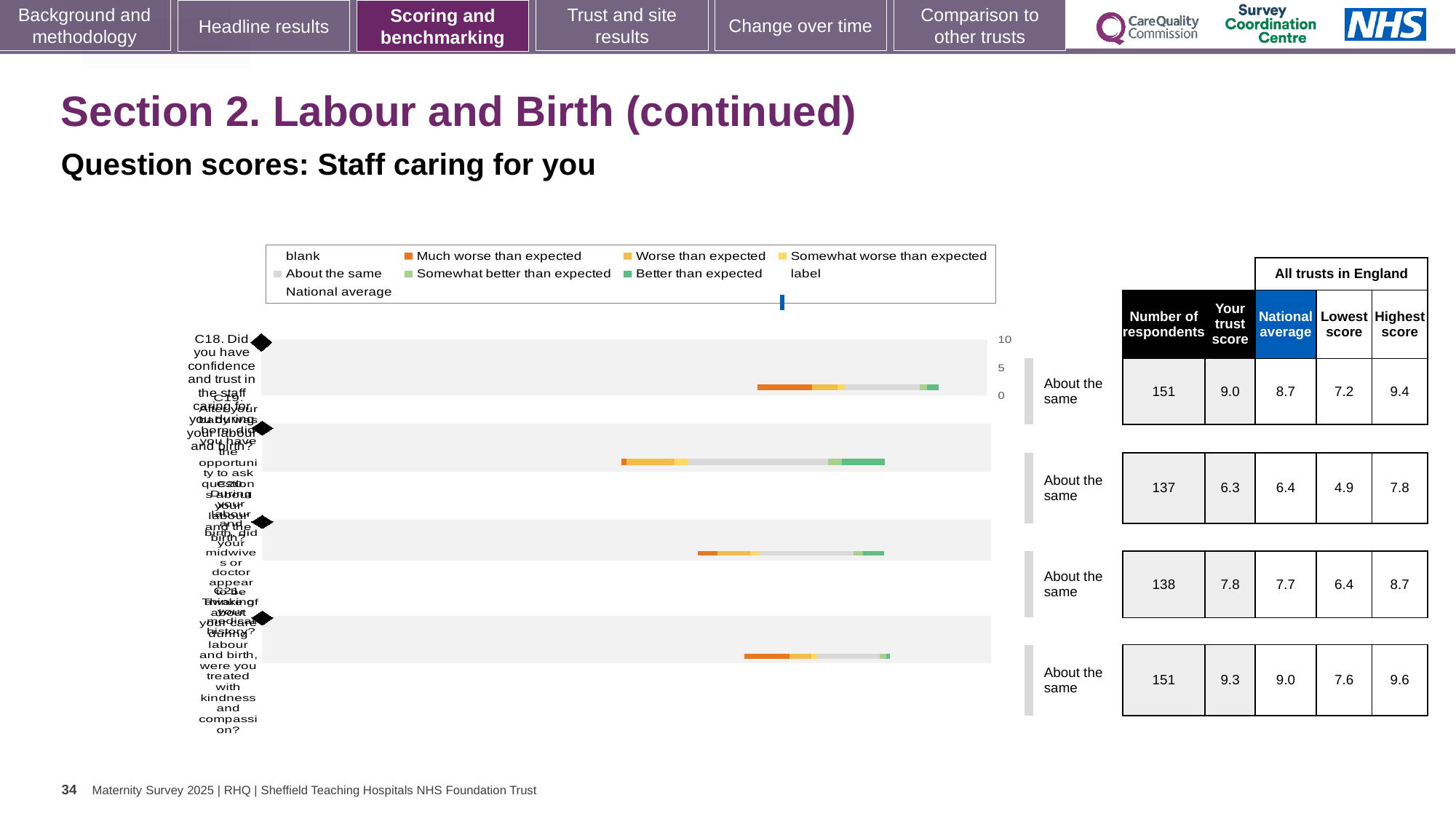
Which row in the table has the lowest 'Your trust score'? the second row (6.3) Which row in the table has the highest 'Your trust score'? the fourth row (9.3) How many question rows are plotted in the chart? 4 In the third row of the table, which is larger: the trust score or the national average? the trust score (7.8) In the table, what is the 'Your trust score' for the first row (C18, confidence and trust in staff)? 9.0 What kind of chart is used to show the question scores on this slide? bar chart In the table, what is the lowest score for the second row? 4.9 In the table, what is the national average for the first row (C18)? 8.7 What is the difference between the trust score and the national average in the first row of the table? 0.3 What benchmark category is shown for all four questions on this slide? About the same In the table, what is the highest score for the fourth row? 9.6 In the table, how many respondents are listed for the second row? 137